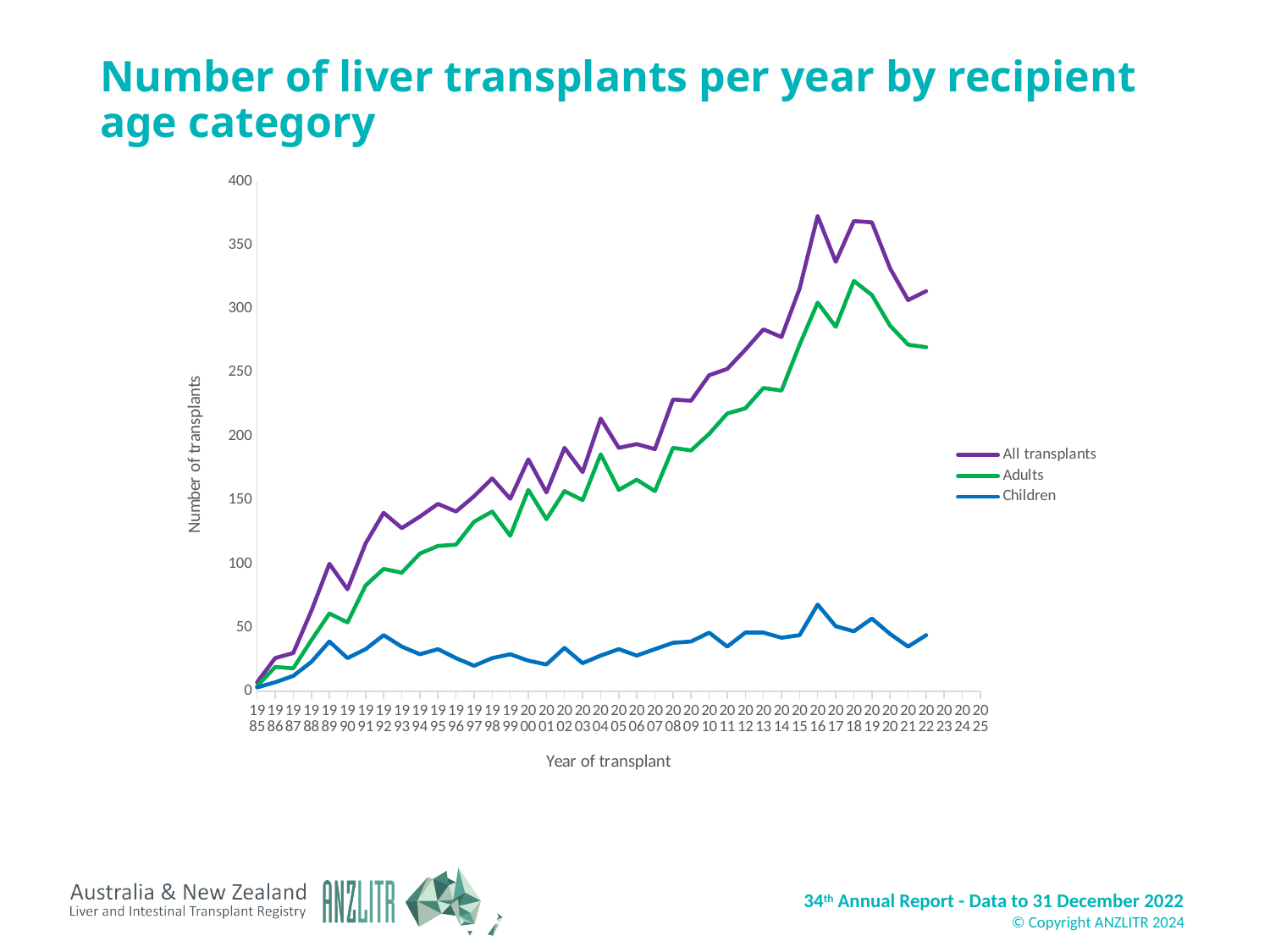
What is the label of the vertical axis? Number of transplants Is the value for All transplants in 2016 greater or less than 350? greater Which series has the larger value in 2022, Adults or Children? Adults Do the values for All transplants generally rise or fall from 1985 to 2016? rise How many series does the legend list? 3 Is the value for All transplants in 1985 greater or less than 50? less Is the value for Children in 2016 greater or less than 50? greater What are the three series listed in the legend? All transplants, Adults, Children What kind of chart is shown on the slide? Line chart In which year does the Children series reach its highest value? 2016